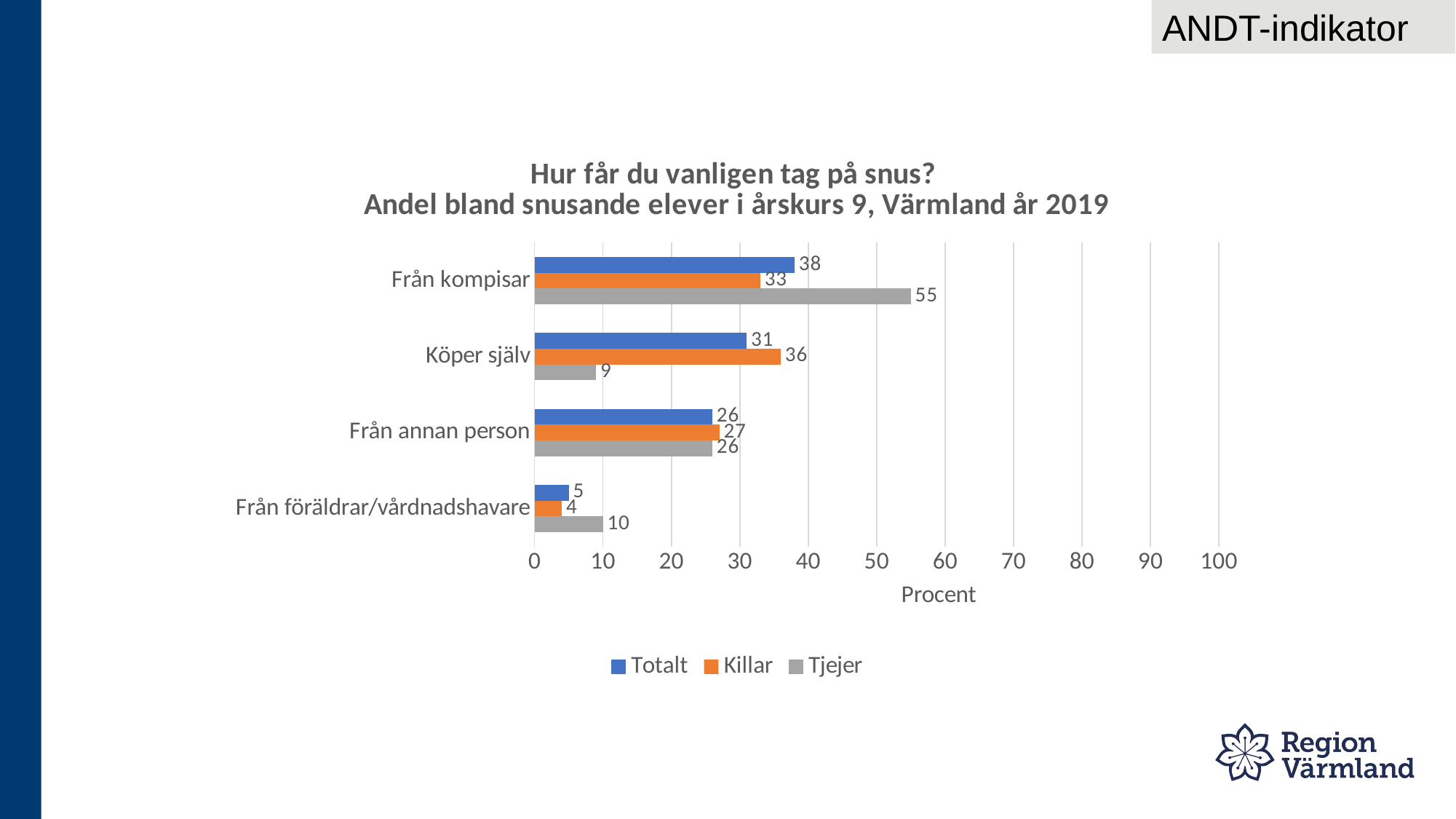
How many series does the legend list? 3 What is the difference between the Tjejer and Killar values for Från kompisar? 22 What kind of chart is shown? bar chart What is the Tjejer value for Från kompisar? 55 Which category has the lowest Tjejer value? Köper själv What is the Totalt value for Från föräldrar/vårdnadshavare? 5 Which is larger for Köper själv, the Killar value or the Tjejer value? Killar Which category has the highest Totalt value? Från kompisar What is the label of the x axis? Procent How many categories are shown on the y axis? 4 Is the Tjejer value for Från kompisar greater or less than 50? greater What is the Killar value for Köper själv? 36